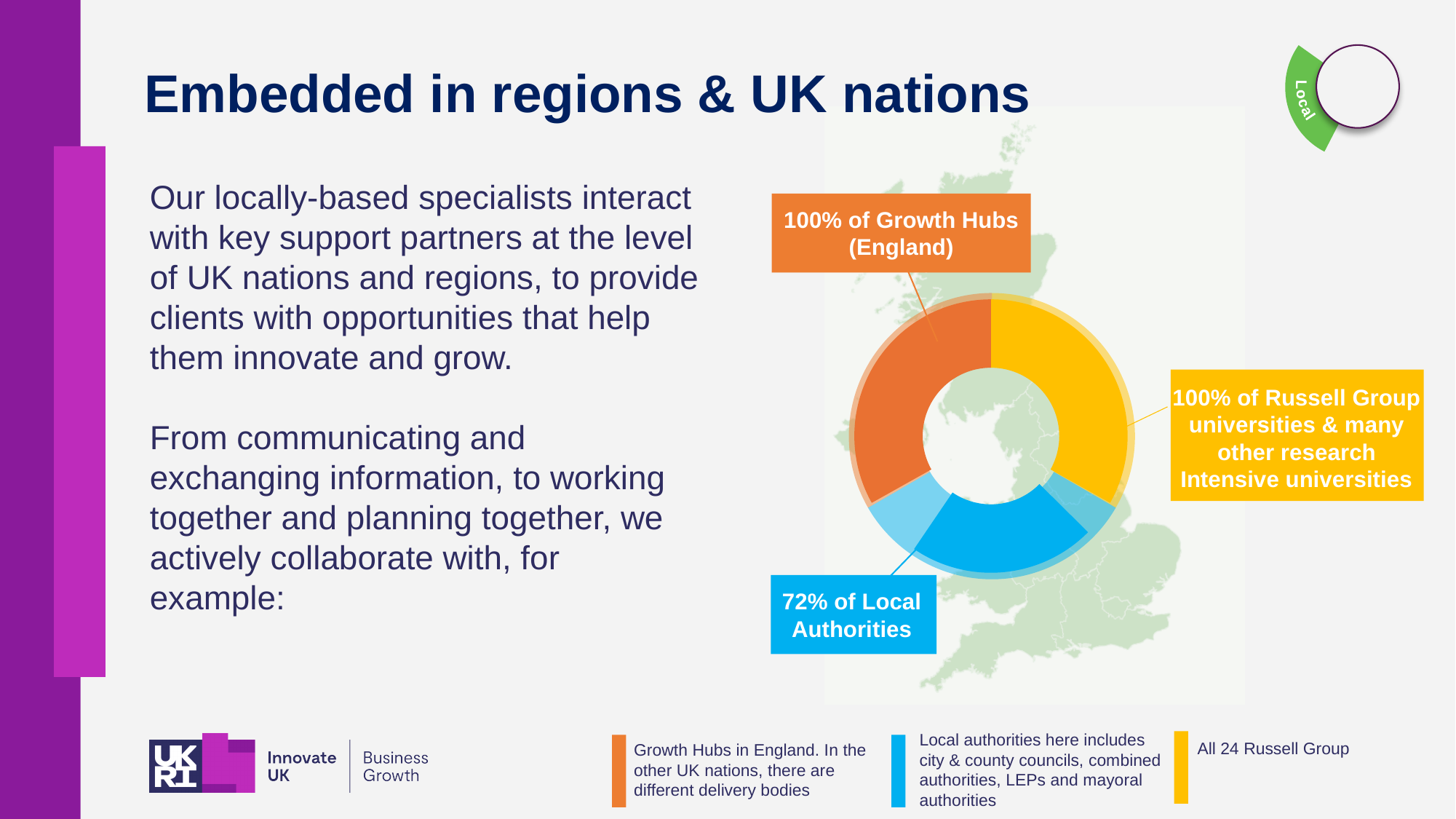
What colour is the Local Authorities segment of the chart? Blue What percentage of Russell Group universities does the chart show? 100% Which is larger: the percentage for Russell Group universities or the percentage for Local Authorities? Russell Group universities What kind of chart is shown on the slide? Pie (donut) chart How many categories are shown on the chart? 3 What percentage of Local Authorities does the chart show? 72% What percentage of Growth Hubs (England) does the chart show? 100% What is the difference between the percentage for Growth Hubs (England) and the percentage for Local Authorities? 28% What colour is the Growth Hubs (England) segment of the chart? Orange Which category has the lowest percentage on the chart? Local Authorities